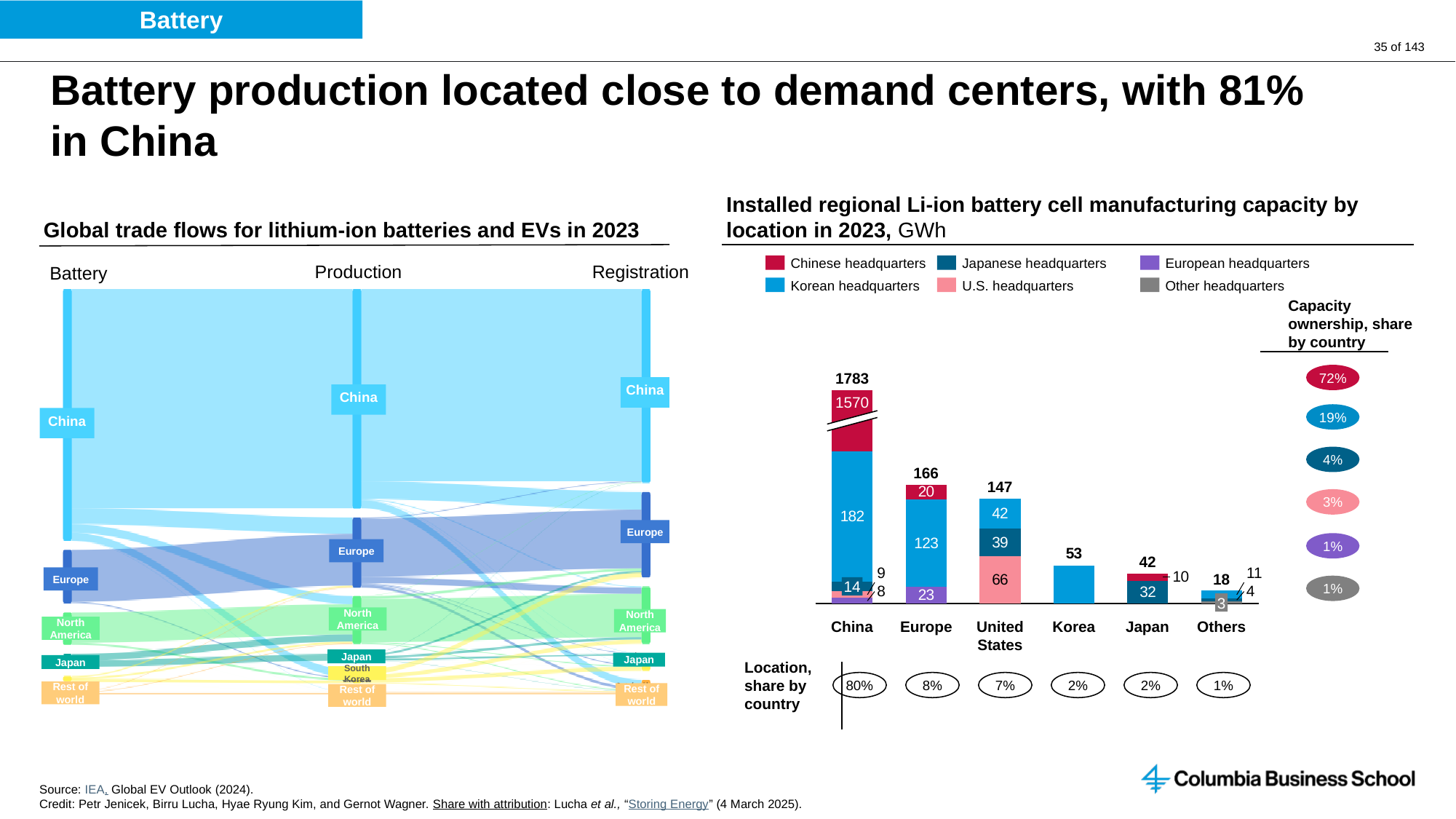
In the 'Installed regional Li-ion battery cell manufacturing capacity' chart, what is the U.S. headquarters capacity located in the United States? 66 In the 'Installed regional Li-ion battery cell manufacturing capacity' chart, what is the Korean headquarters capacity located in Europe? 123 In the 'Installed regional Li-ion battery cell manufacturing capacity' chart, which location has the highest total capacity? China In the 'Installed regional Li-ion battery cell manufacturing capacity' chart, what is the difference between the total capacity for Europe and the total for the United States? 19 In the 'Installed regional Li-ion battery cell manufacturing capacity' chart, what is the total capacity for China? 1783 How many locations are shown on the x axis of the 'Installed regional Li-ion battery cell manufacturing capacity' chart? 6 In the 'Installed regional Li-ion battery cell manufacturing capacity' chart, which location has the lowest total capacity? Others What kind of chart is the 'Installed regional Li-ion battery cell manufacturing capacity' chart? Stacked bar chart In the 'Installed regional Li-ion battery cell manufacturing capacity' chart, what is the Japanese headquarters capacity located in Japan? 32 In the 'Installed regional Li-ion battery cell manufacturing capacity' chart, which has a larger total capacity, Korea or Japan? Korea How many series does the legend of the 'Installed regional Li-ion battery cell manufacturing capacity' chart list? 6 In the 'Installed regional Li-ion battery cell manufacturing capacity' chart, what is the location share by country shown for China? 80%